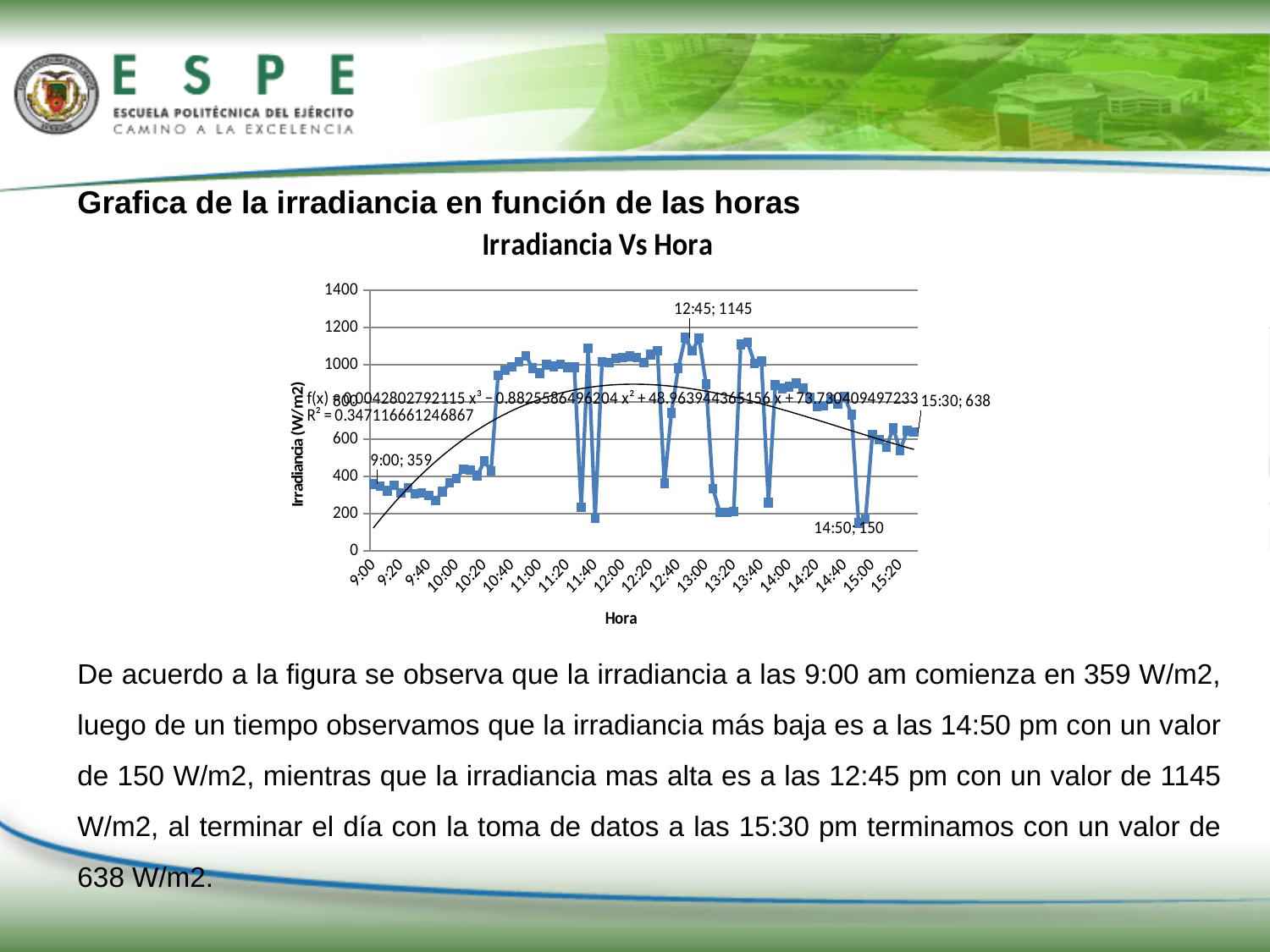
By how much does the labelled value at 15:30 exceed the labelled value at 9:00? 279 Is the irradiance value at 11:00 greater or less than 800? greater What is the irradiance value labelled at 14:50 on the chart? 150 At what time does the chart show the lowest irradiance value? 14:50 What kind of chart is shown on the slide? Line chart At what time does the chart show the highest irradiance value? 12:45 What is the irradiance value labelled at 15:30 on the chart? 638 What is the irradiance value labelled at 9:00 on the Irradiancia Vs Hora chart? 359 Which has the larger irradiance value, 12:45 or 15:30? 12:45 What is the irradiance value labelled at 12:45 on the chart? 1145 What is the label of the vertical axis of the chart? Irradiancia (W/m2) What is the difference between the labelled maximum (12:45) and minimum (14:50) irradiance values? 995